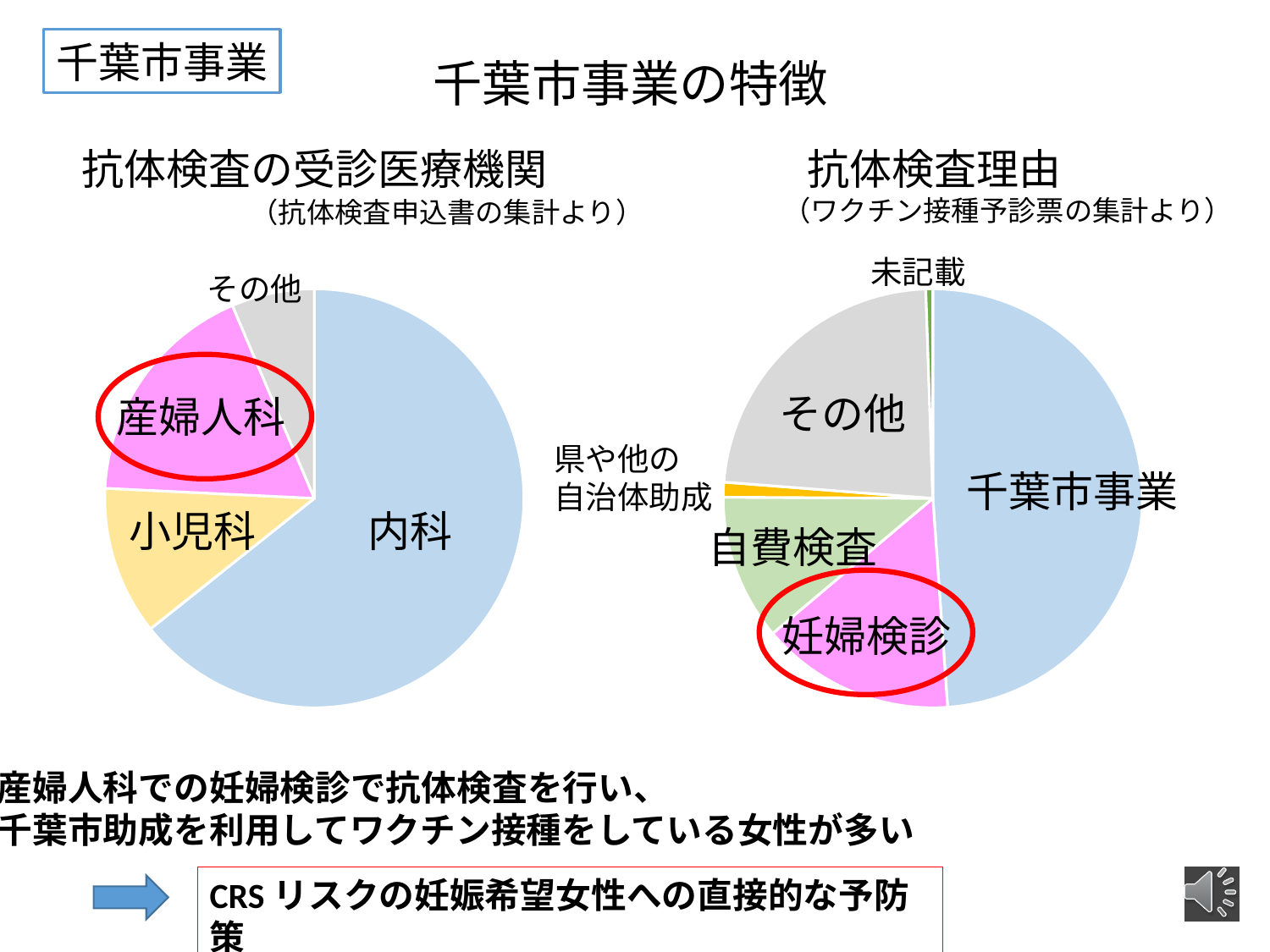
In the right chart (抗体検査理由), which is larger, 妊婦検診 or 県や他の自治体助成? 妊婦検診 In the left chart (抗体検査の受診医療機関), which slice is circled in red? 産婦人科 In the right chart (抗体検査理由), which is larger, 千葉市事業 or その他? 千葉市事業 In the left chart (抗体検査の受診医療機関), which is larger, 内科 or 産婦人科? 内科 In the left chart (抗体検査の受診医療機関), how many slices are there? 4 In the right chart (抗体検査理由), which slice is circled in red? 妊婦検診 What kind of chart is the right chart titled 抗体検査理由? Pie chart In the right chart (抗体検査理由), which category has the largest share? 千葉市事業 In the right chart (抗体検査理由), how many slices are there? 6 In the left chart (抗体検査の受診医療機関), which category has the largest share? 内科 What kind of chart is the left chart titled 抗体検査の受診医療機関? Pie chart